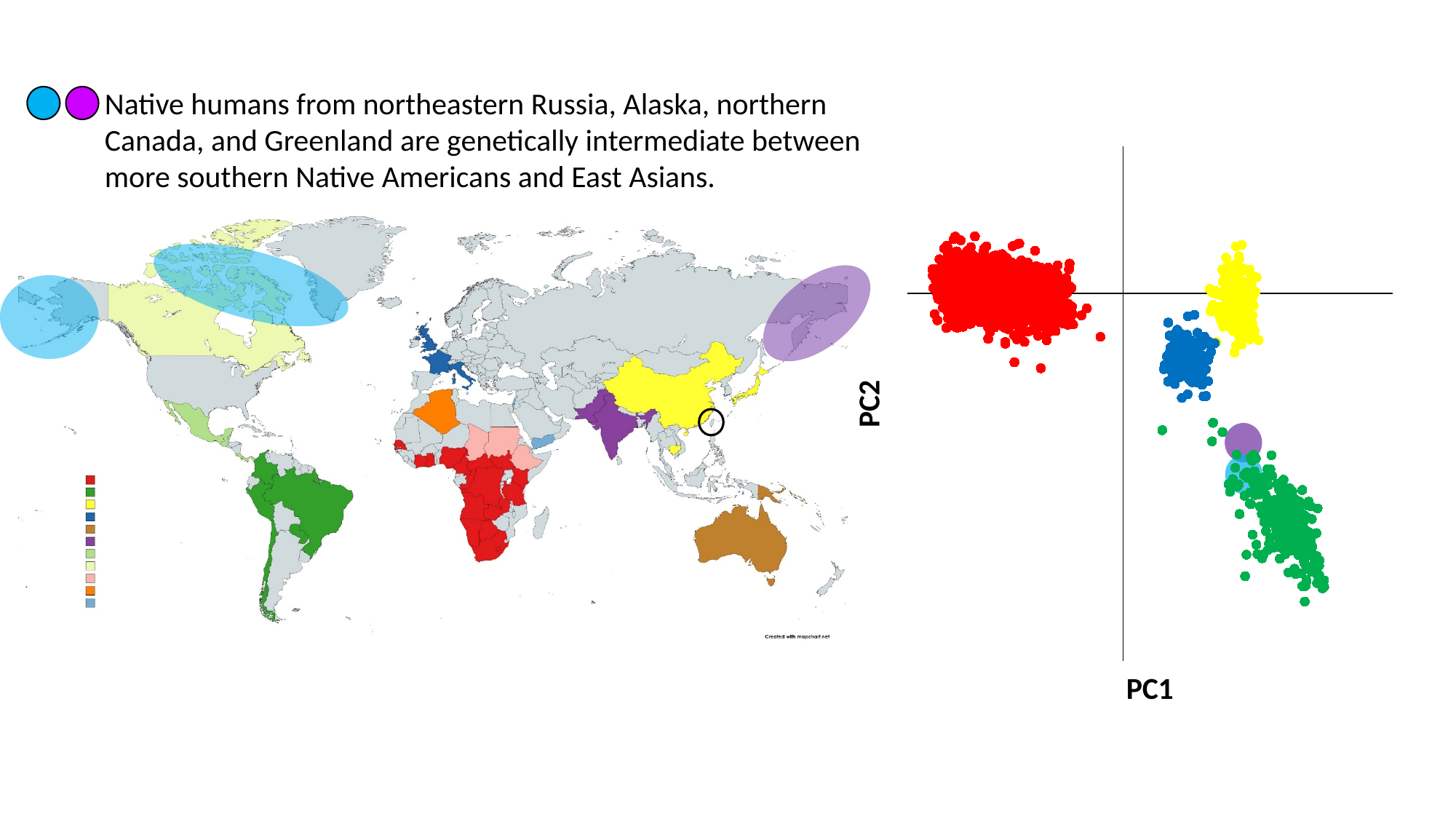
In the scatter plot on the right, which cluster is positioned further right along PC1, the blue cluster or the yellow cluster? yellow In the scatter plot on the right, which cluster is positioned lower along PC2, the blue cluster or the yellow cluster? blue In the scatter plot on the right, which colored cluster of points lies furthest to the left along PC1? red What kind of chart is shown on the right side of the slide? scatter plot In the scatter plot on the right, what two colors are the ellipses overlaid between the blue and green clusters? purple and light blue In the scatter plot on the right, what are the labels of the horizontal and vertical axes? PC1 and PC2 In the scatter plot on the right, is the red cluster to the left or to the right of the vertical axis line? left In the scatter plot on the right, which colored cluster of points extends lowest along PC2? green In the scatter plot on the right, which colored cluster of points extends furthest to the right along PC1? green